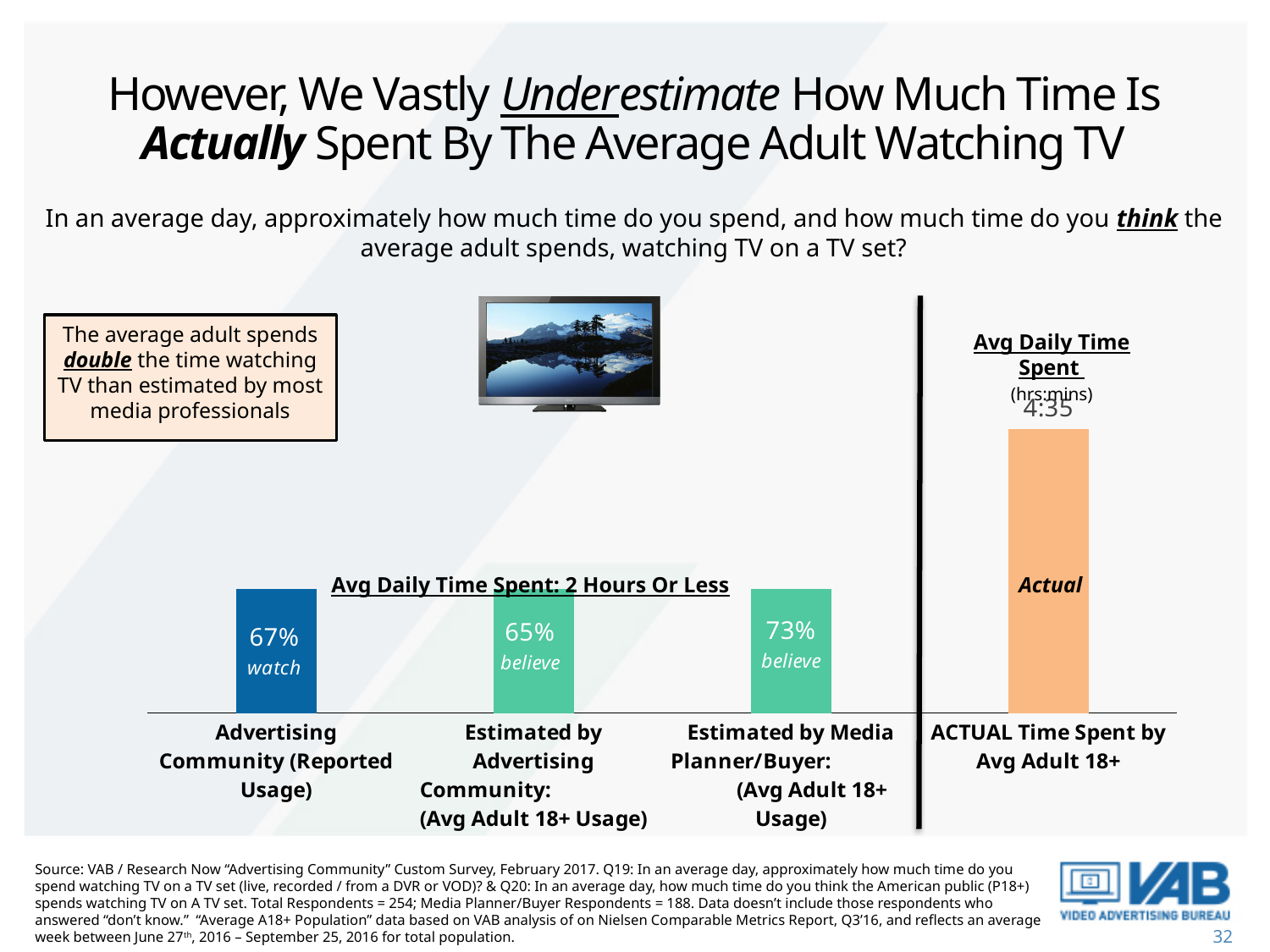
What percentage of Media Planners/Buyers believe the average adult 18+ watches TV for 2 hours or less per day? 73% What is the actual average daily time spent watching TV by the average adult 18+, as shown on the chart? 4:35 Among the three percentage bars, which category has the lowest value? Estimated by Advertising Community: (Avg Adult 18+ Usage) What is the difference in percentage points between the Media Planner/Buyer estimate (73%) and the Advertising Community estimate (65%)? 8 percentage points What percentage of the Advertising Community reported watching TV for 2 hours or less per day? 67% What is the difference in percentage points between the Advertising Community's reported usage (67%) and its estimate for the average adult (65%)? 2 percentage points Which is larger: the Advertising Community's reported usage percentage or the Media Planner/Buyer estimate percentage? Media Planner/Buyer estimate (73%) Among the three percentage bars, which category has the highest value? Estimated by Media Planner/Buyer: (Avg Adult 18+ Usage) What colour is the bar for ACTUAL Time Spent by Avg Adult 18+? Orange How many bars are plotted on the chart? 4 What type of chart is shown on the slide? Bar chart What percentage of the Advertising Community believe the average adult 18+ watches TV for 2 hours or less per day? 65%